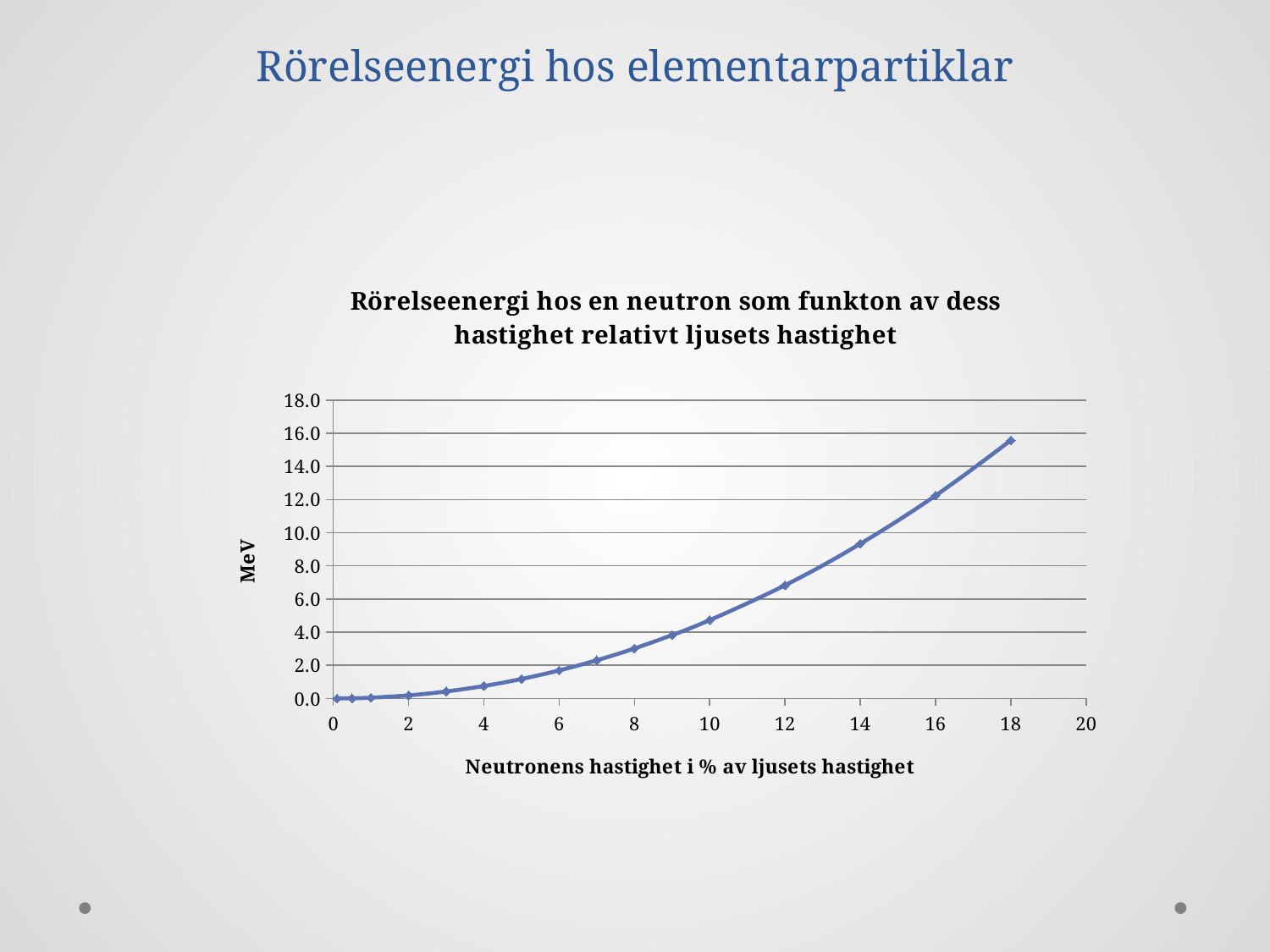
Is the value at 18% of the speed of light greater or less than 14.0 MeV? greater Which is larger, the value at 10% or the value at 14% of the speed of light? 14% At which x-axis value (neutron speed in % of light speed) is the kinetic energy lowest? 0 Is the value at 16% of the speed of light greater or less than 10.0 MeV? greater Is the value at 12% of the speed of light greater or less than 6.0 MeV? greater What is the label on the x axis of the chart? Neutronens hastighet i % av ljusets hastighet Do the values rise or fall as the neutron's speed increases along the x axis? rise What is the label on the y axis of the chart? MeV What kind of chart is shown on the slide? line chart At which x-axis value (neutron speed in % of light speed) is the kinetic energy highest? 18